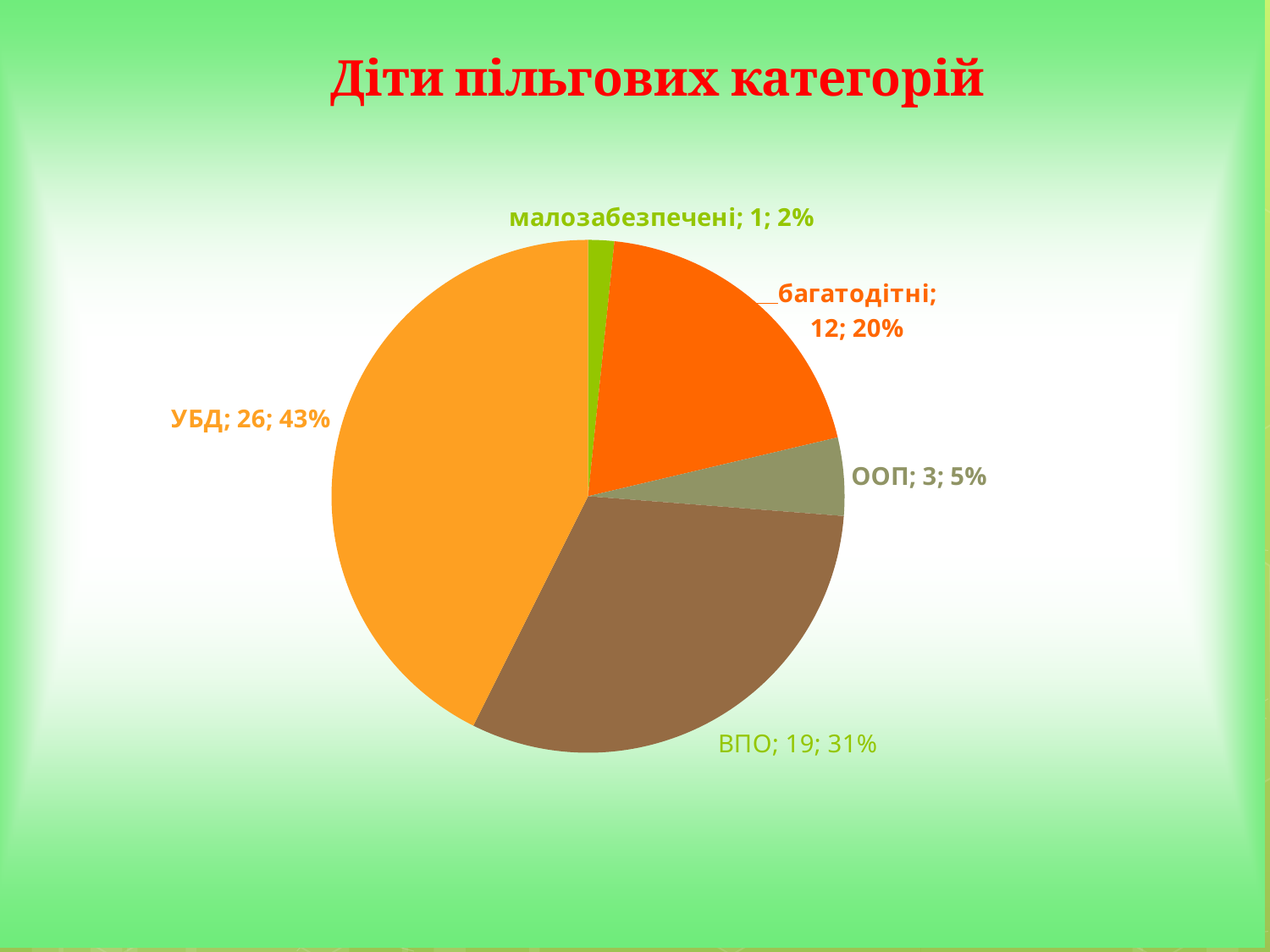
What is the value for ООП? 3 What is the difference between the values for УБД and ВПО? 7 Which category has the largest slice? УБД Which category has the smallest slice? малозабезпечені What is the value for ВПО? 19 Which is larger, the value for багатодітні or the value for ООП? багатодітні What kind of chart is shown on the slide? pie chart What share of the pie does ВПО represent? 31% What share of the pie does багатодітні represent? 20% What is the value for УБД? 26 What is the value for багатодітні? 12 How many categories does the pie chart show? 5